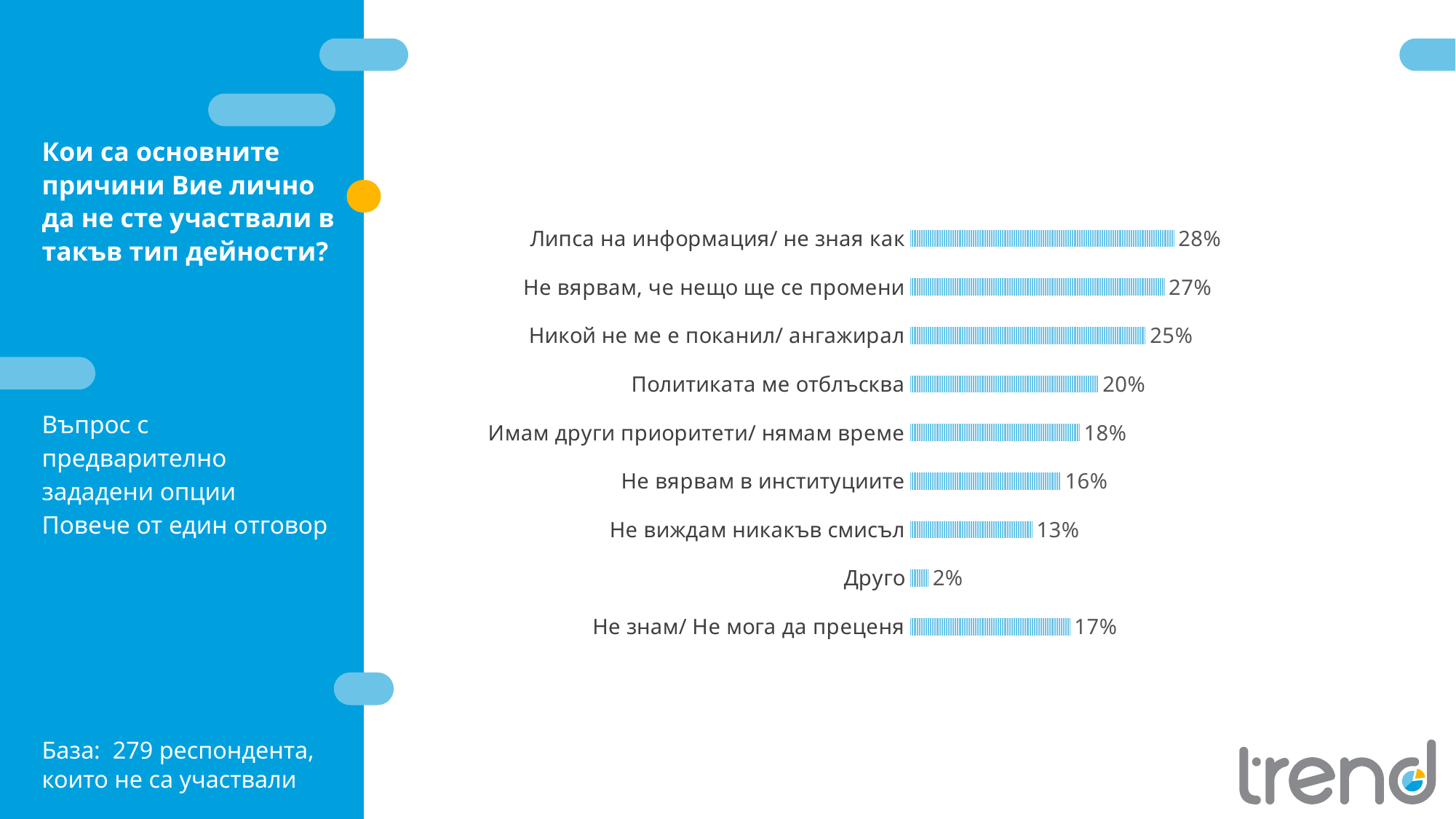
What is the difference between "Никой не ме е поканил/ ангажирал" and "Не виждам никакъв смисъл"? 12% What kind of chart is shown on the slide? Bar chart How many respondents form the base for this chart, according to the slide? 279 What is the value for "Не вярвам в институциите"? 16% Which is larger: "Имам други приоритети/ нямам време" or "Не вярвам в институциите"? Имам други приоритети/ нямам време How many categories are shown in the chart? 9 What is the difference between "Не вярвам, че нещо ще се промени" and "Друго"? 25% Which category has the lowest value? Друго What is the value for "Политиката ме отблъсква"? 20% What is the value for "Липса на информация/ не зная как"? 28% Which category has the highest value? Липса на информация/ не зная как What is the value for "Не знам/ Не мога да преценя"? 17%